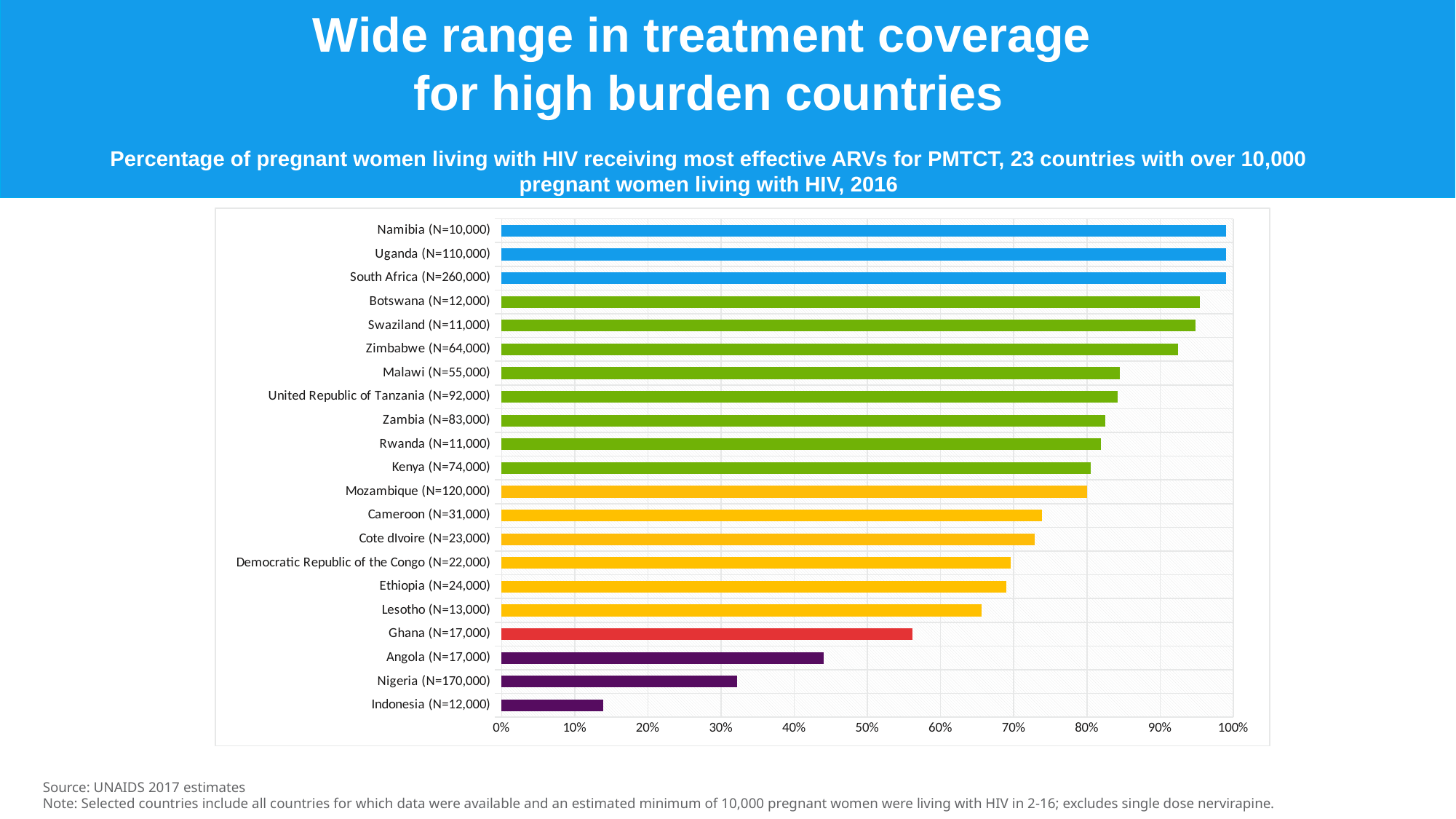
Which has a higher value, Ghana (N=17,000) or Angola (N=17,000)? Ghana (N=17,000) What colour is the bar for Ghana (N=17,000)? Red Which country has the lowest percentage in the chart? Indonesia (N=12,000) Is the value for Angola (N=17,000) greater or less than 50%? less Is the value for Lesotho (N=13,000) greater or less than 70%? less Is the value for Nigeria (N=170,000) greater or less than 30%? greater Which has a higher value, Cameroon (N=31,000) or Lesotho (N=13,000)? Cameroon (N=31,000) How many countries are plotted in the chart? 21 What kind of chart is shown on the slide? Bar chart